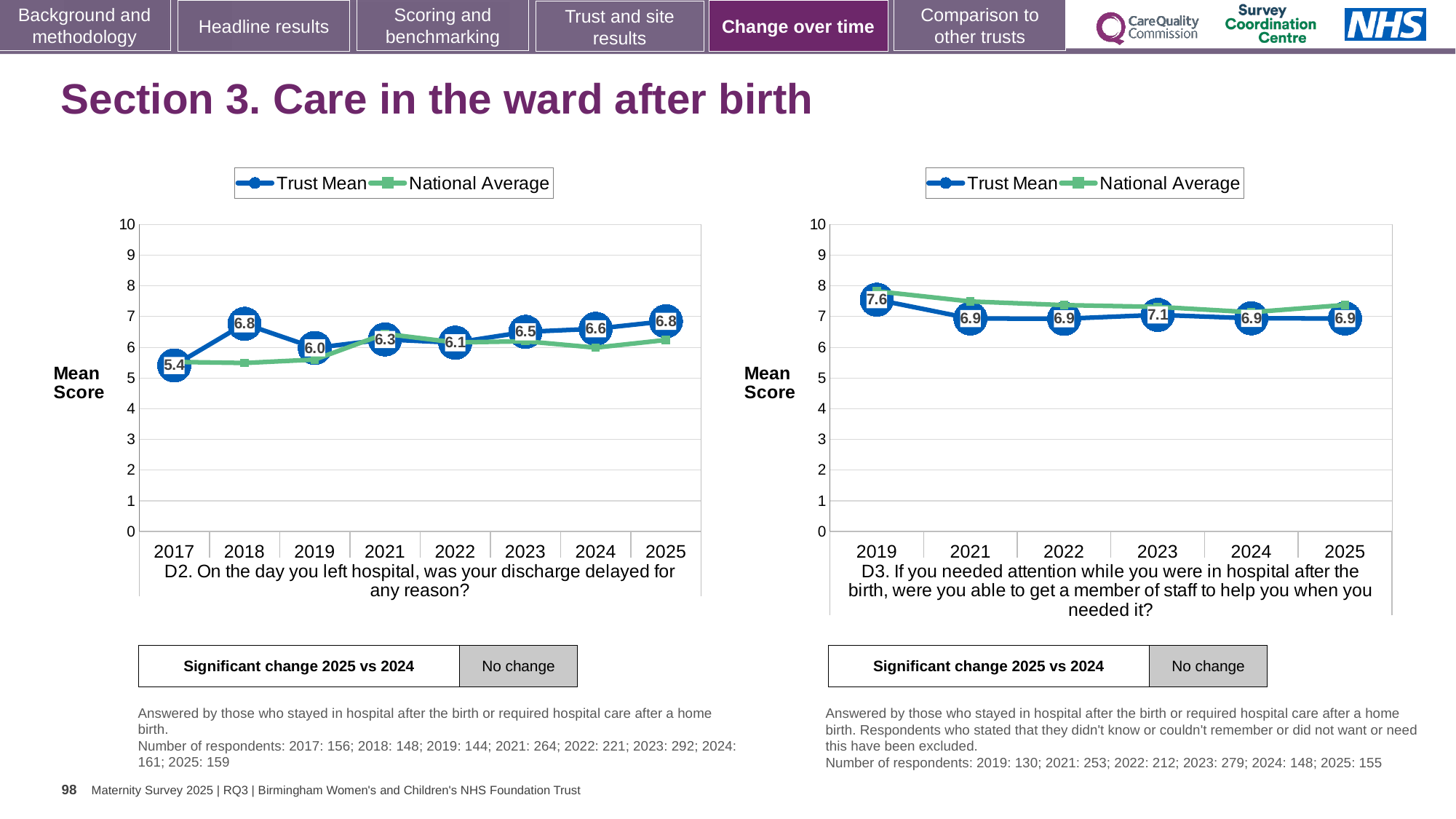
In the right chart (D3), what is the Trust Mean score for 2023? 7.1 How many years are plotted on the x axis of the right chart (D3)? 6 In the right chart (D3), which year has the highest Trust Mean score? 2019 In the left chart (D2), what is the Trust Mean score for 2017? 5.4 In the right chart (D3), is the National Average value for 2019 greater or less than 7? greater How many series does the legend of the left chart (D2) list? 2 In the left chart (D2), what is the Trust Mean score for 2023? 6.5 In the left chart (D2), what is the difference between the Trust Mean scores for 2018 and 2017? 1.4 In the right chart (D3), what is the Trust Mean score for 2019? 7.6 In the left chart (D2), is the Trust Mean score higher in 2019 or in 2024? 2024 In the left chart (D2), which year has the lowest Trust Mean score? 2017 In the right chart (D3), what is the difference between the Trust Mean scores for 2019 and 2025? 0.7